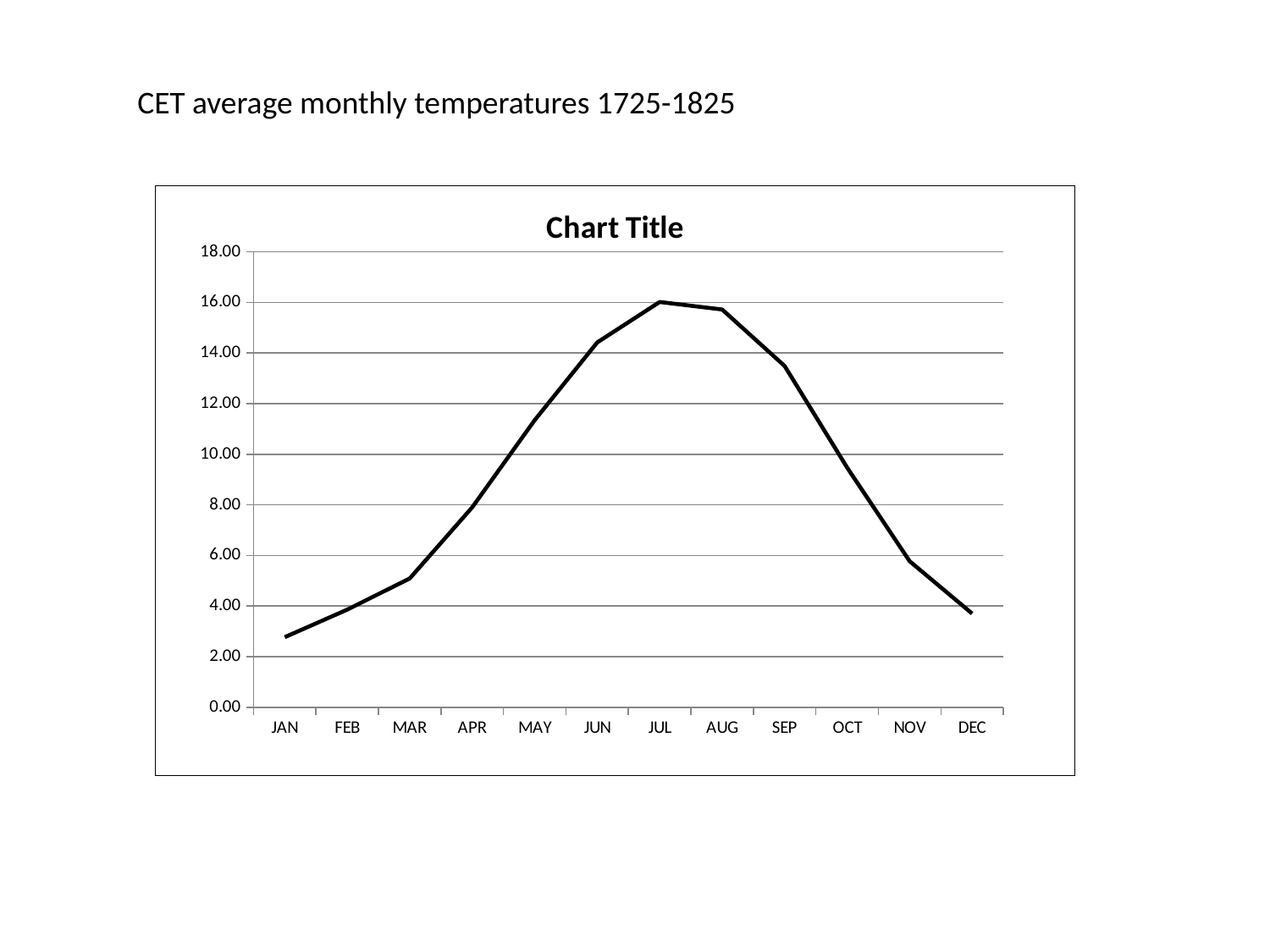
Is the value for SEP greater or less than 12.00? greater Is the value for JUL greater or less than 14.00? greater Is the value for JAN greater or less than 4.00? less What kind of chart is shown on the slide? line chart Which is larger, the value for APR or the value for NOV? APR What is the title text shown above the plot area of the chart? Chart Title Do the values rise or fall from JAN to JUL? rise Which is larger, the value for MAY or the value for OCT? MAY Which month has the lowest average temperature? JAN Which month has the highest average temperature? JUL How many months are plotted along the x axis? 12